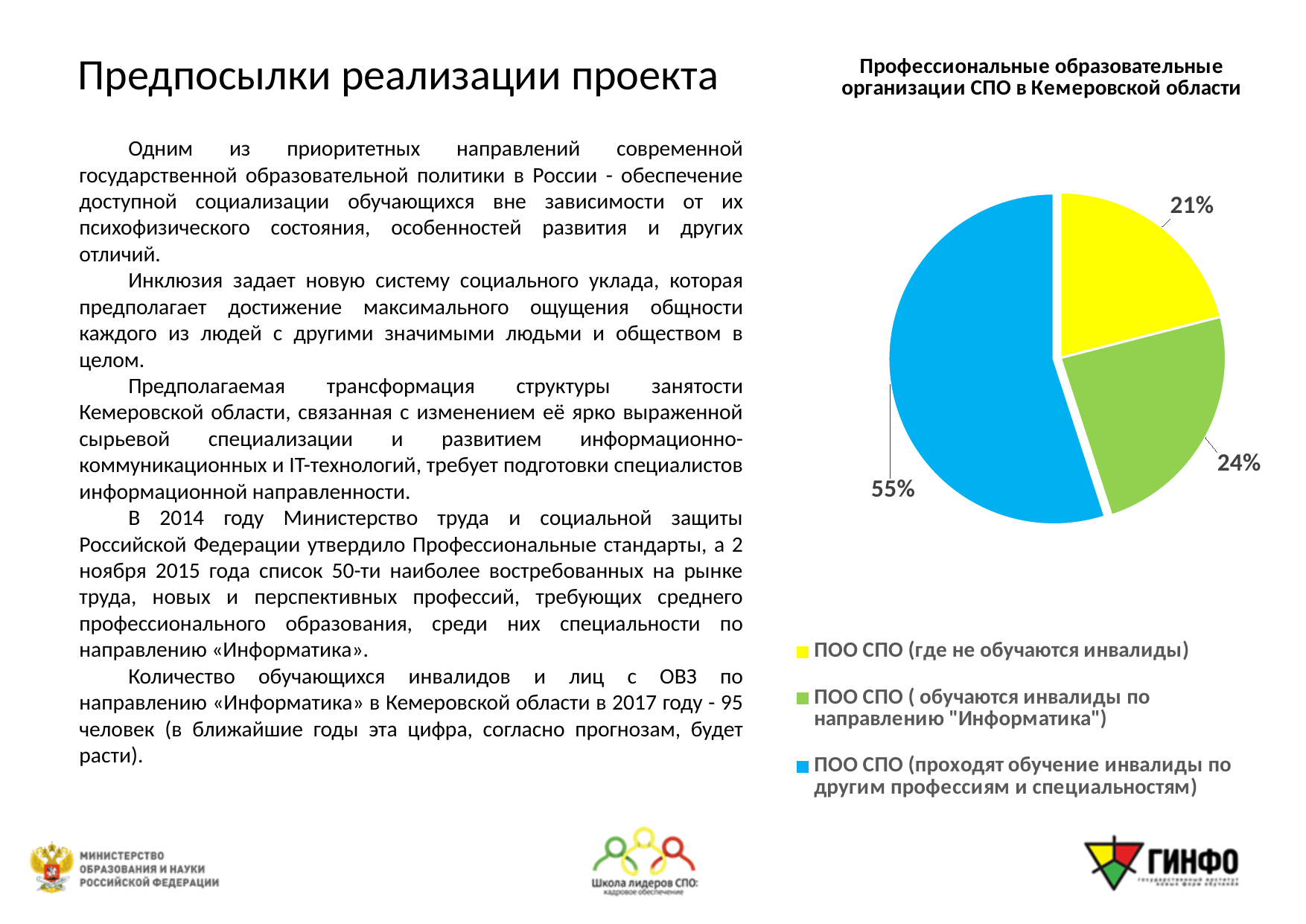
What is the difference in percentage points between the 55% slice and the 24% slice? 31 How many slices does the pie chart have? 3 What share of the pie is ПОО СПО (где не обучаются инвалиды)? 21% What is the title of the chart? Профессиональные образовательные организации СПО в Кемеровской области Which category has the smallest slice of the pie? ПОО СПО (где не обучаются инвалиды) How many entries does the chart legend list? 3 What share of the pie is ПОО СПО (проходят обучение инвалиды по другим профессиям и специальностям)? 55% What kind of chart is shown on the slide? pie chart Which category has the largest slice of the pie? ПОО СПО (проходят обучение инвалиды по другим профессиям и специальностям) Which is larger: the share for ПОО СПО (где не обучаются инвалиды) or the share for ПОО СПО (обучаются инвалиды по направлению "Информатика")? ПОО СПО (обучаются инвалиды по направлению "Информатика") What colour is the slice representing ПОО СПО (проходят обучение инвалиды по другим профессиям и специальностям)? blue What share of the pie is ПОО СПО (обучаются инвалиды по направлению "Информатика")? 24%